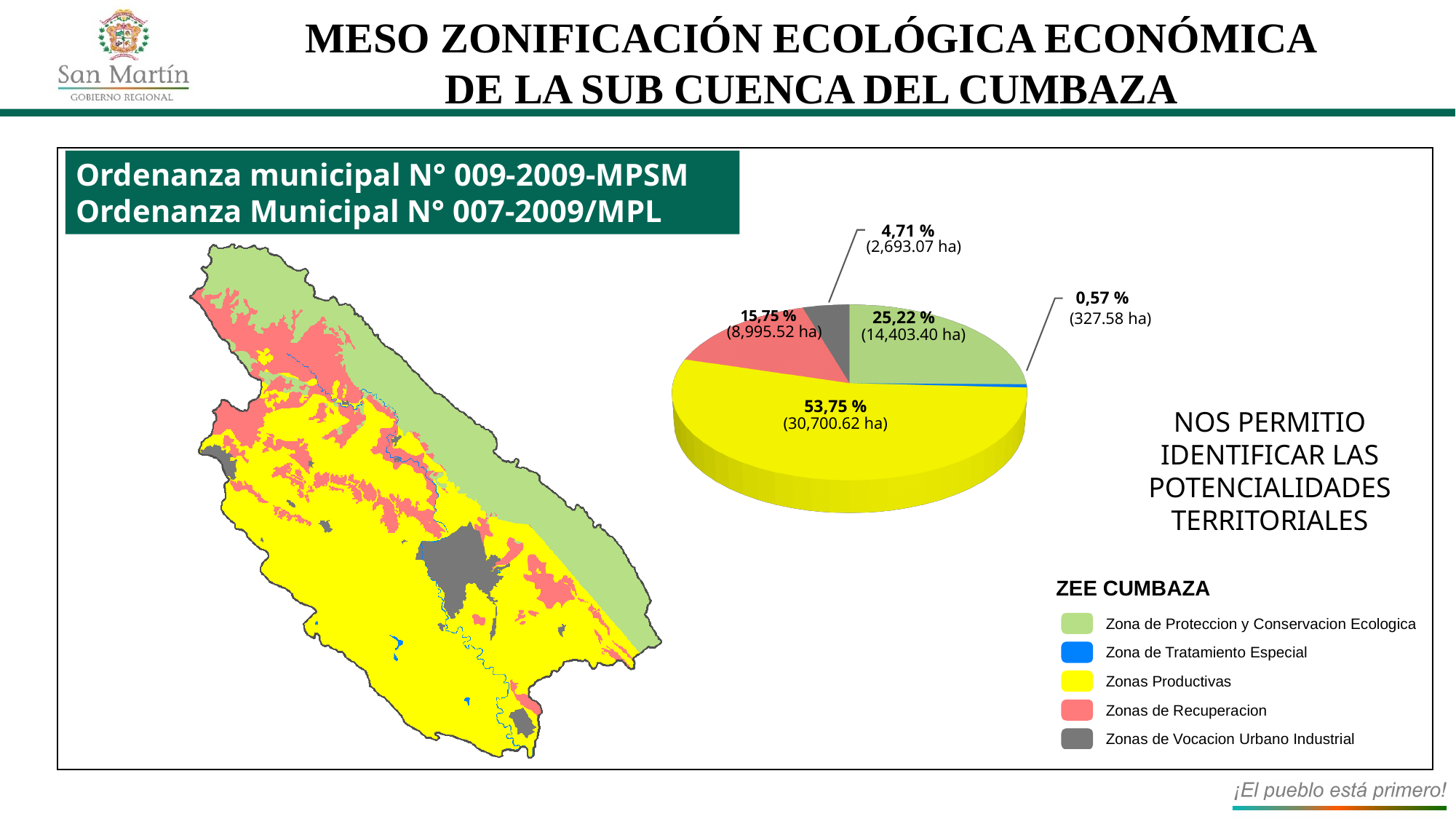
What area in hectares is shown for Zona de Tratamiento Especial? 327.58 ha What percentage of the pie chart is Zona de Proteccion y Conservacion Ecologica? 25,22 % Which zone has the smallest share of the pie chart? Zona de Tratamiento Especial Which zone has the largest share of the pie chart? Zonas Productivas What colour represents Zonas de Vocacion Urbano Industrial in the pie chart? grey What area in hectares is shown for Zonas Productivas? 30,700.62 ha How many entries does the ZEE CUMBAZA legend list? 5 What area in hectares is shown for Zonas de Recuperacion? 8,995.52 ha Which has a larger share of the pie chart, Zonas de Recuperacion or Zonas de Vocacion Urbano Industrial? Zonas de Recuperacion What percentage of the pie chart is Zonas Productivas? 53,75 % What kind of chart is shown on the slide? pie chart How many slices does the pie chart have? 5